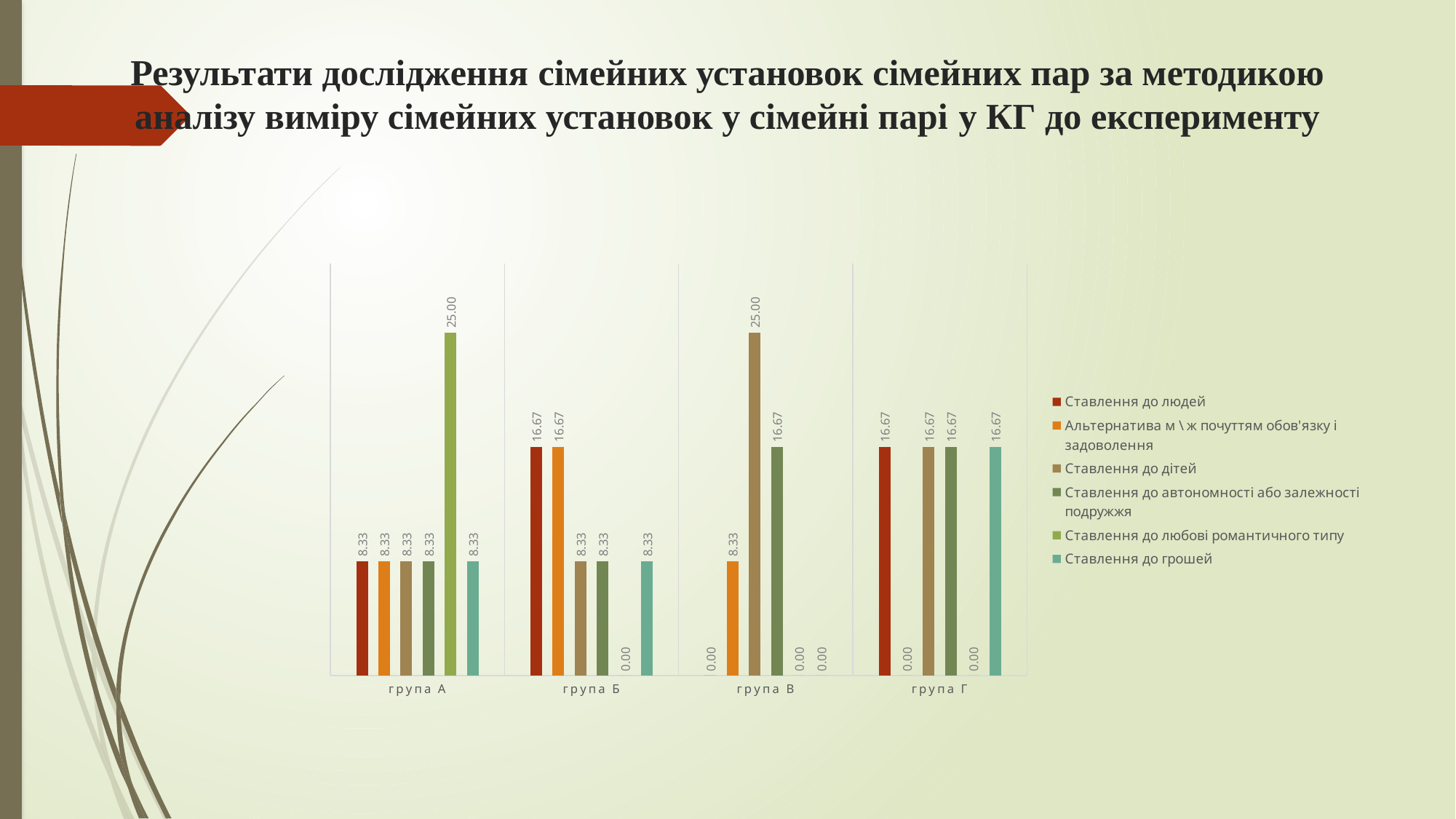
What is the value of Ставлення до любові романтичного типу for група А? 25.00 What is the value of Ставлення до любові романтичного типу for група Г? 0.00 What is the value of Ставлення до людей for група Б? 16.67 How many groups (categories) are shown on the x axis? 4 What is the value of Ставлення до грошей for група Г? 16.67 Which series has the highest value in група А? Ставлення до любові романтичного типу What kind of chart is shown on the slide? bar chart Which series has the highest value in група В? Ставлення до дітей What is the value of Ставлення до дітей for група В? 25.00 In група Б, which is larger: Ставлення до людей or Ставлення до дітей? Ставлення до людей How many series does the legend list? 6 In група А, what is the difference between Ставлення до любові романтичного типу and Ставлення до людей? 16.67